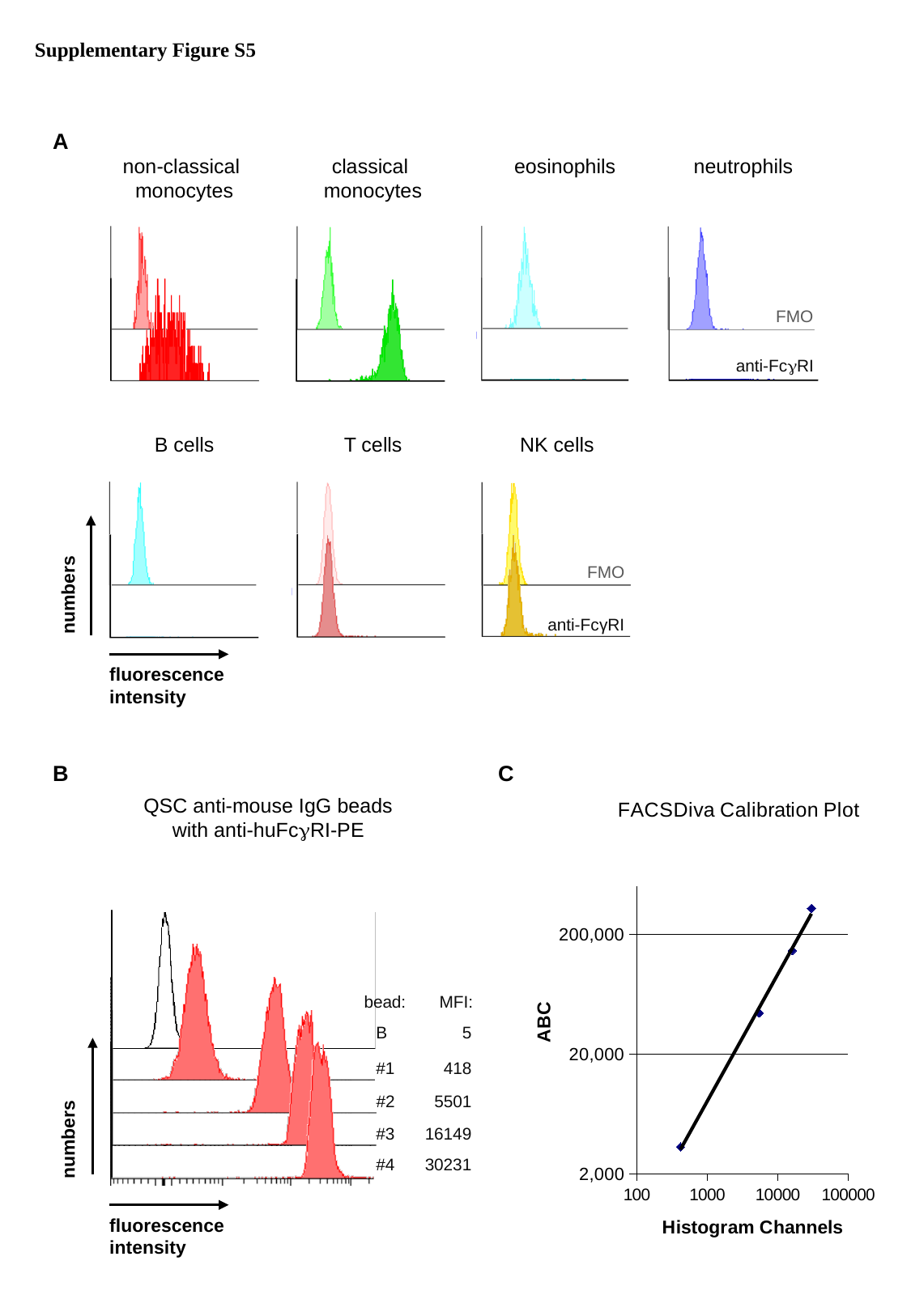
In panel B (QSC anti-mouse IgG beads), what is the difference in MFI between bead #3 and bead #1? 15731 In panel C (FACSDiva Calibration Plot), is the ABC value of the highest point greater or less than 200,000? greater In panel C (FACSDiva Calibration Plot), does ABC rise or fall as Histogram Channels increase? rise In panel C (FACSDiva Calibration Plot), how many data points are plotted? 4 In panel B (QSC anti-mouse IgG beads), what is the MFI listed for bead #2? 5501 In panel B (QSC anti-mouse IgG beads), how many beads are listed in the MFI table? 5 In panel B (QSC anti-mouse IgG beads), which bead has the lowest MFI? B In panel B (QSC anti-mouse IgG beads), what is the MFI listed for bead B? 5 In panel A, how many cell types are shown with histograms? 7 In panel C (FACSDiva Calibration Plot), what is the label of the x axis? Histogram Channels In panel B (QSC anti-mouse IgG beads), which bead has the highest MFI? #4 In panel B (QSC anti-mouse IgG beads), what is the MFI listed for bead #4? 30231